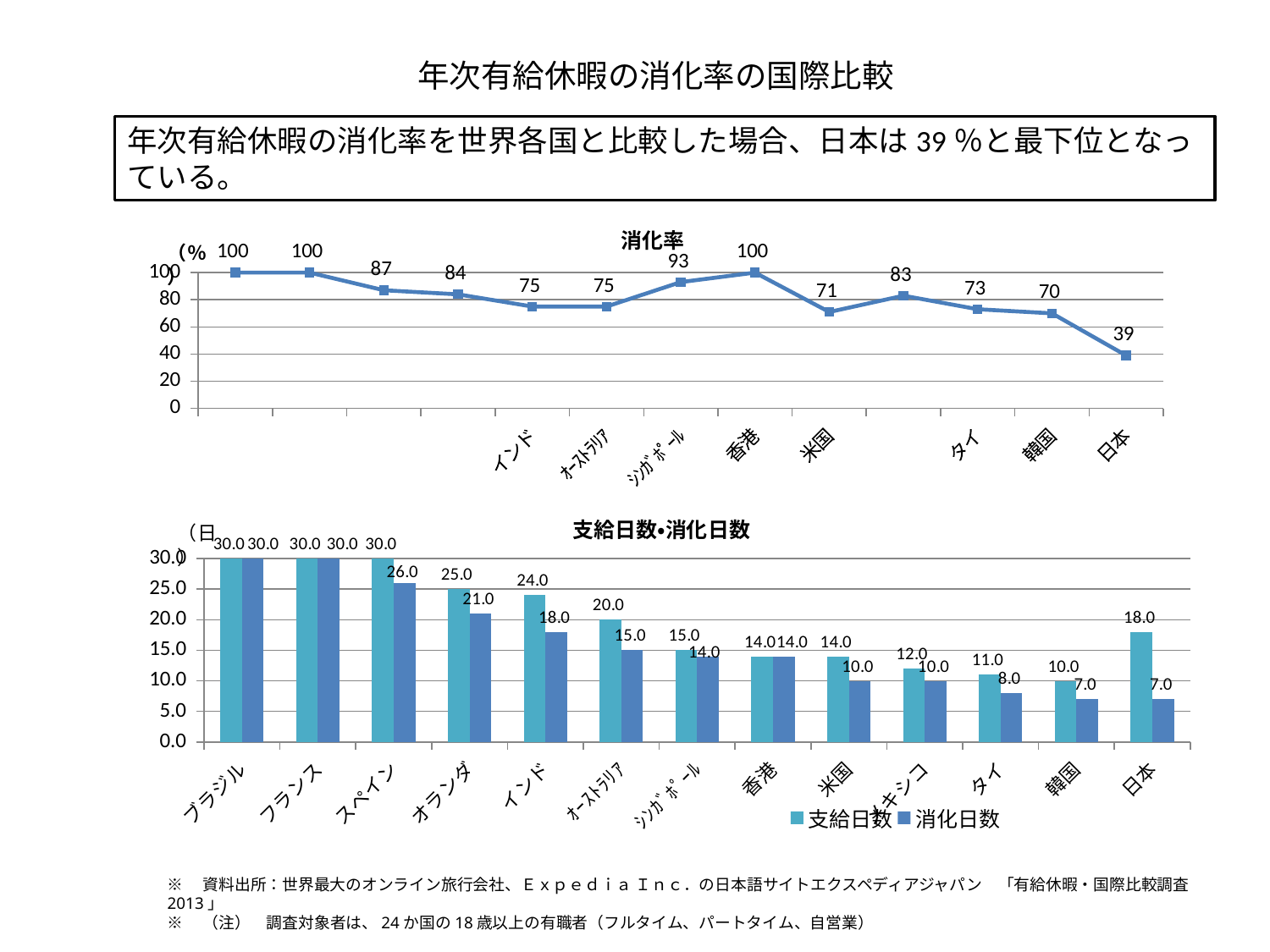
In the bottom chart titled 支給日数•消化日数, what is the 消化日数 value for スペイン? 26.0 In the top chart titled 消化率, what is the value for シンガポール? 93 What kind of chart is the bottom chart titled 支給日数•消化日数? bar chart In the bottom chart titled 支給日数•消化日数, what is the 支給日数 value for 日本? 18.0 In the bottom chart titled 支給日数•消化日数, how many countries are shown on the x axis? 13 In the bottom chart titled 支給日数•消化日数, what is the difference between the 支給日数 and 消化日数 values for インド? 6.0 In the bottom chart titled 支給日数•消化日数, how many series does the legend list? 2 In the top chart titled 消化率, what is the value for 日本? 39 In the top chart titled 消化率, which labelled country has the lowest value? 日本 In the top chart titled 消化率, which is larger, the value for タイ or the value for 韓国? タイ What kind of chart is the top chart titled 消化率? line chart In the top chart titled 消化率, what is the difference between the values for 香港 and 米国? 29